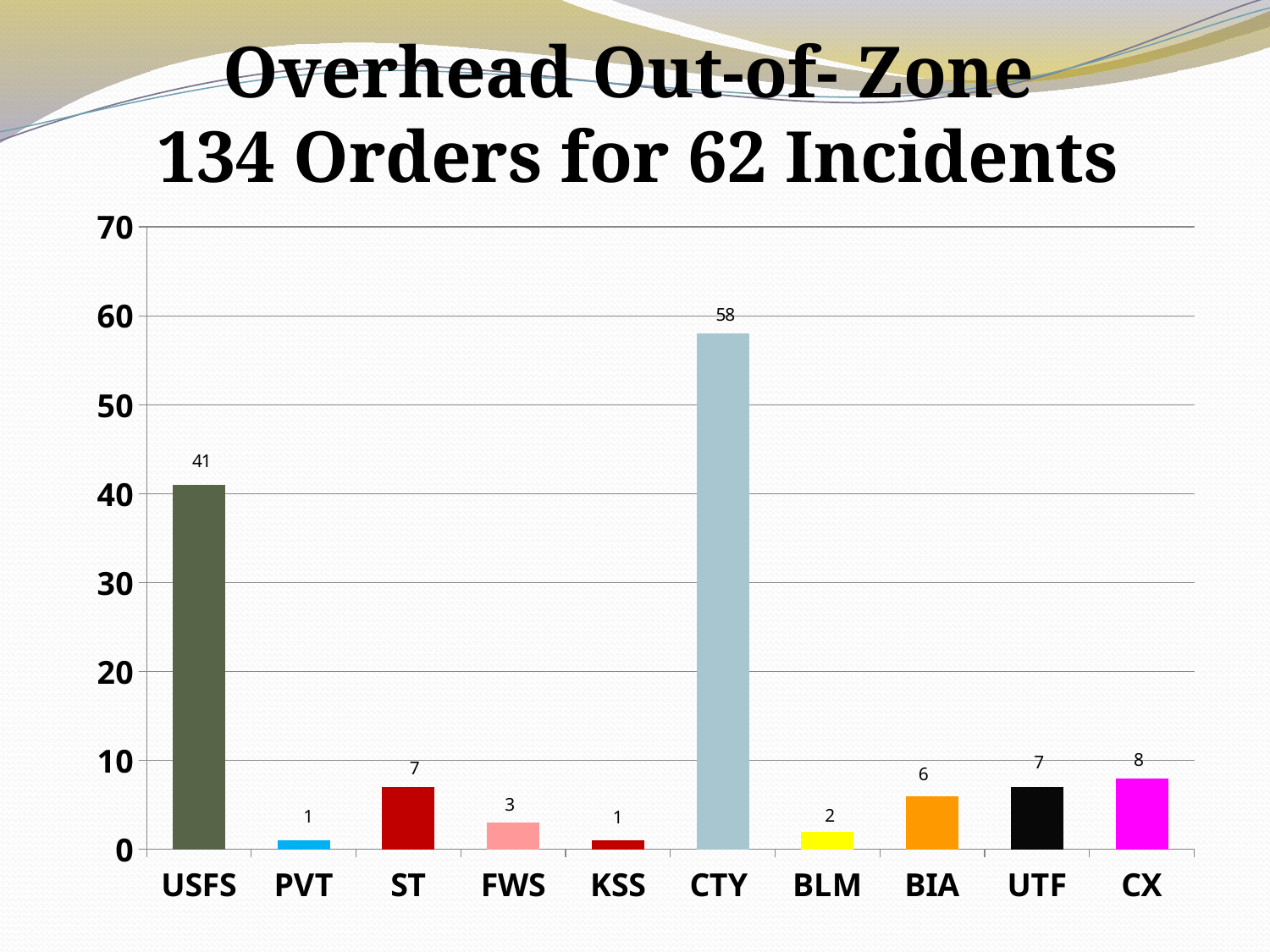
What is the value for BIA? 6 What is the value for CTY? 58 Which is larger, the value for ST or the value for FWS? ST Which category has the highest value? CTY Which categories share the lowest value of 1? PVT and KSS What kind of chart is shown on the slide? bar chart What is the value for USFS? 41 Is the value for USFS greater or less than 40? greater What is the difference between the values for CX and BLM? 6 What is the difference between the values for CTY and USFS? 17 How many categories are shown on the x axis? 10 What is the title of the chart? Overhead Out-of- Zone 134 Orders for 62 Incidents